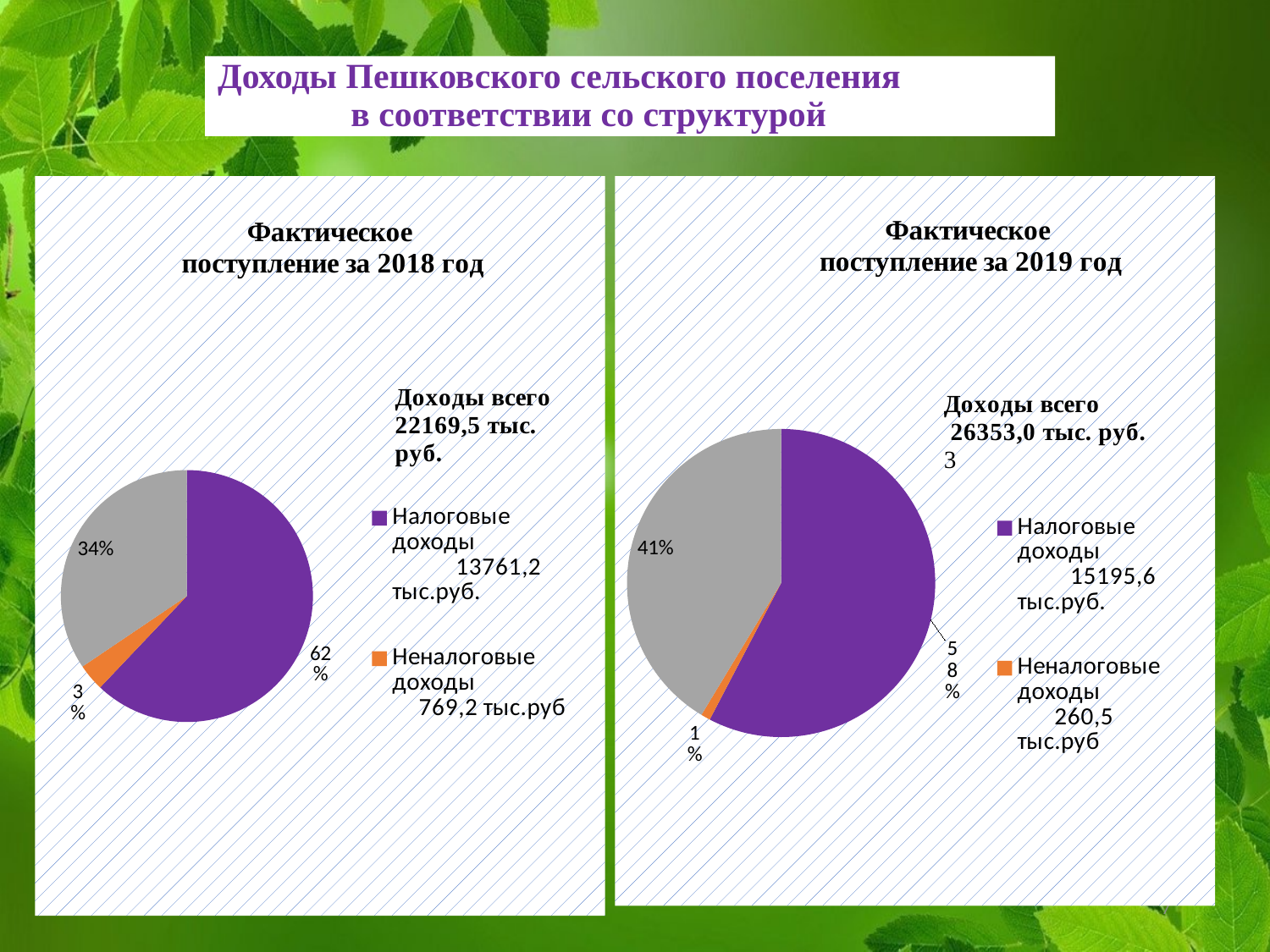
In the "Фактическое поступление за 2018 год" chart, what share of the pie is Налоговые доходы? 62% What kind of chart is "Фактическое поступление за 2018 год"? pie chart How many slices does the "Фактическое поступление за 2019 год" pie chart have? 3 In the "Фактическое поступление за 2018 год" chart, what value is given for Налоговые доходы? 13761,2 тыс.руб. In the "Фактическое поступление за 2019 год" chart, what share of the pie is Неналоговые доходы? 1% Which is larger: Налоговые доходы in the 2018 chart or Налоговые доходы in the 2019 chart? 2019 (15195,6 тыс.руб.) In the "Фактическое поступление за 2018 год" chart, what share of the pie is Неналоговые доходы? 3% In the "Фактическое поступление за 2019 год" chart, which category has the smallest slice? Неналоговые доходы In the "Фактическое поступление за 2018 год" chart, what is the value of Доходы всего? 22169,5 тыс. руб. In the "Фактическое поступление за 2018 год" chart, which labelled category has the largest slice? Налоговые доходы In the "Фактическое поступление за 2019 год" chart, what value is given for Неналоговые доходы? 260,5 тыс.руб